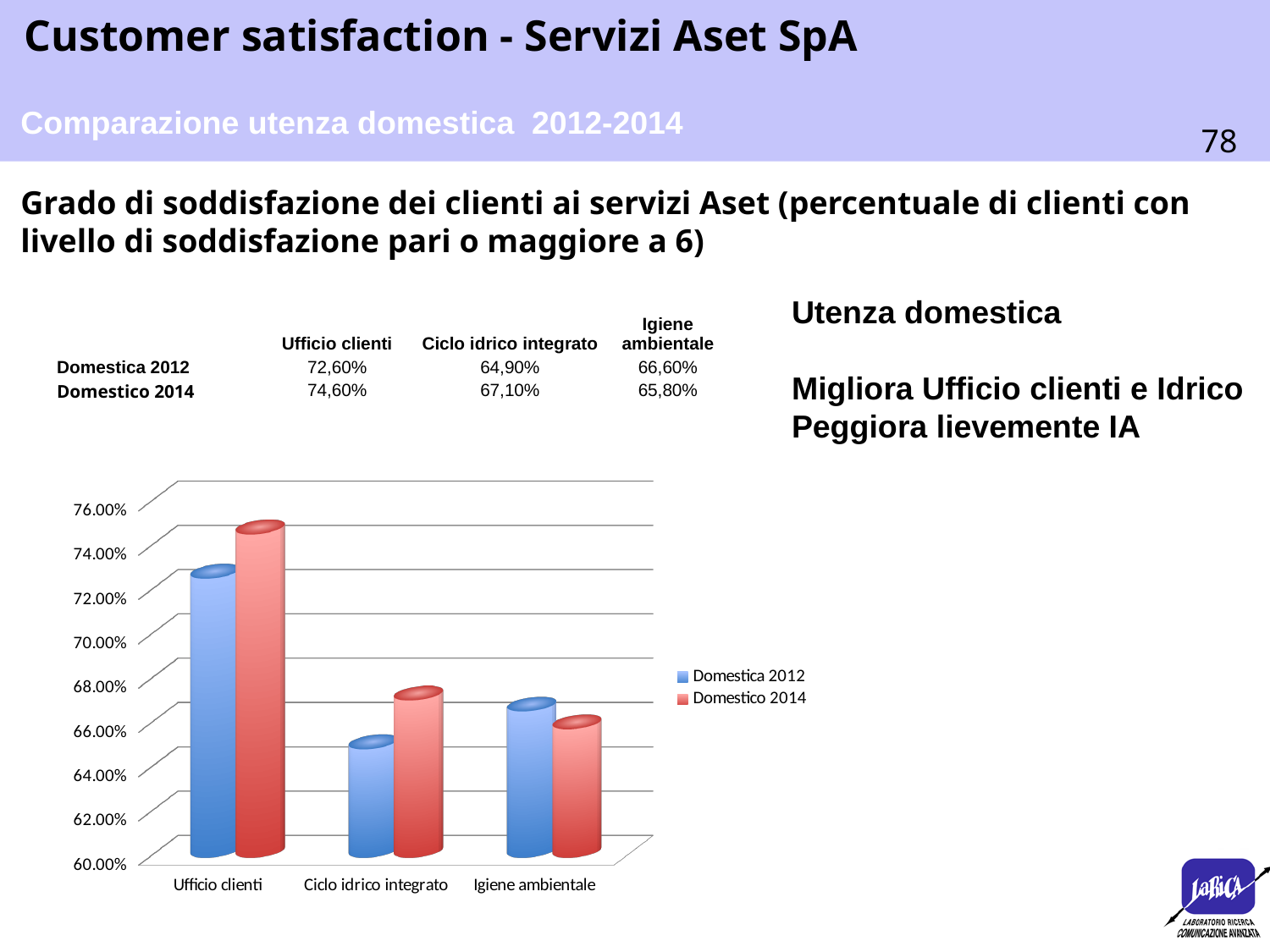
What is the value for Ciclo idrico integrato in the Domestico 2014 series? 67,10% What is the value for Ufficio clienti in the Domestica 2012 series? 72,60% What is the value for Igiene ambientale in the Domestica 2012 series? 66,60% What kind of chart is shown on the slide? bar chart How many categories are shown on the x axis of the chart? 3 Which category has the lowest value in the Domestica 2012 series? Ciclo idrico integrato How many series does the chart legend list? 2 Which category has the highest value in the Domestico 2014 series? Ufficio clienti By how much did the value for Ufficio clienti change from Domestica 2012 to Domestico 2014? 2,00% For Igiene ambientale, which series has the larger value, Domestica 2012 or Domestico 2014? Domestica 2012 Is the Domestica 2012 value for Ciclo idrico integrato greater or less than 66.00%? less What is the difference between Domestica 2012 and Domestico 2014 for Igiene ambientale? 0,80%